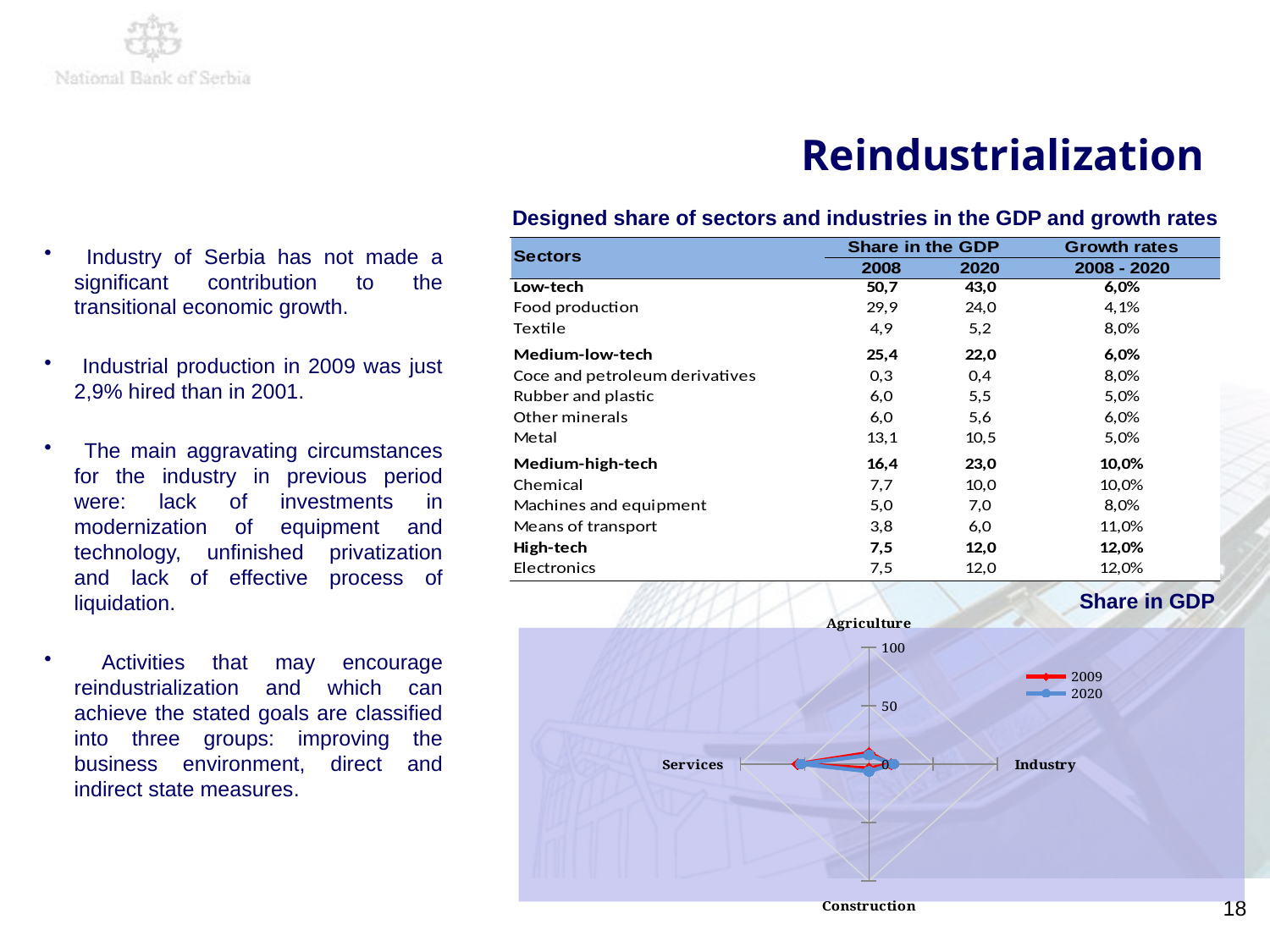
Which years are listed in the legend of the "Share in GDP" chart? 2009 and 2020 How many series does the legend of the "Share in GDP" chart list? 2 In the "Share in GDP" chart, which is larger for 2009: the value for Services or the value for Agriculture? Services In the "Share in GDP" chart, is the 2009 value for Agriculture greater or less than 50? less In the "Share in GDP" chart, is the 2020 value for Industry greater or less than 50? less In the "Share in GDP" chart, which category has the highest value for 2009? Services What kind of chart is the "Share in GDP" chart? Radar chart How many categories (axes) does the "Share in GDP" radar chart have? 4 What are the four categories shown on the "Share in GDP" radar chart? Agriculture, Industry, Construction, Services In the "Share in GDP" chart, is the 2009 value for Services greater or less than 100? less In the "Share in GDP" chart, which category has the highest value for 2020? Services